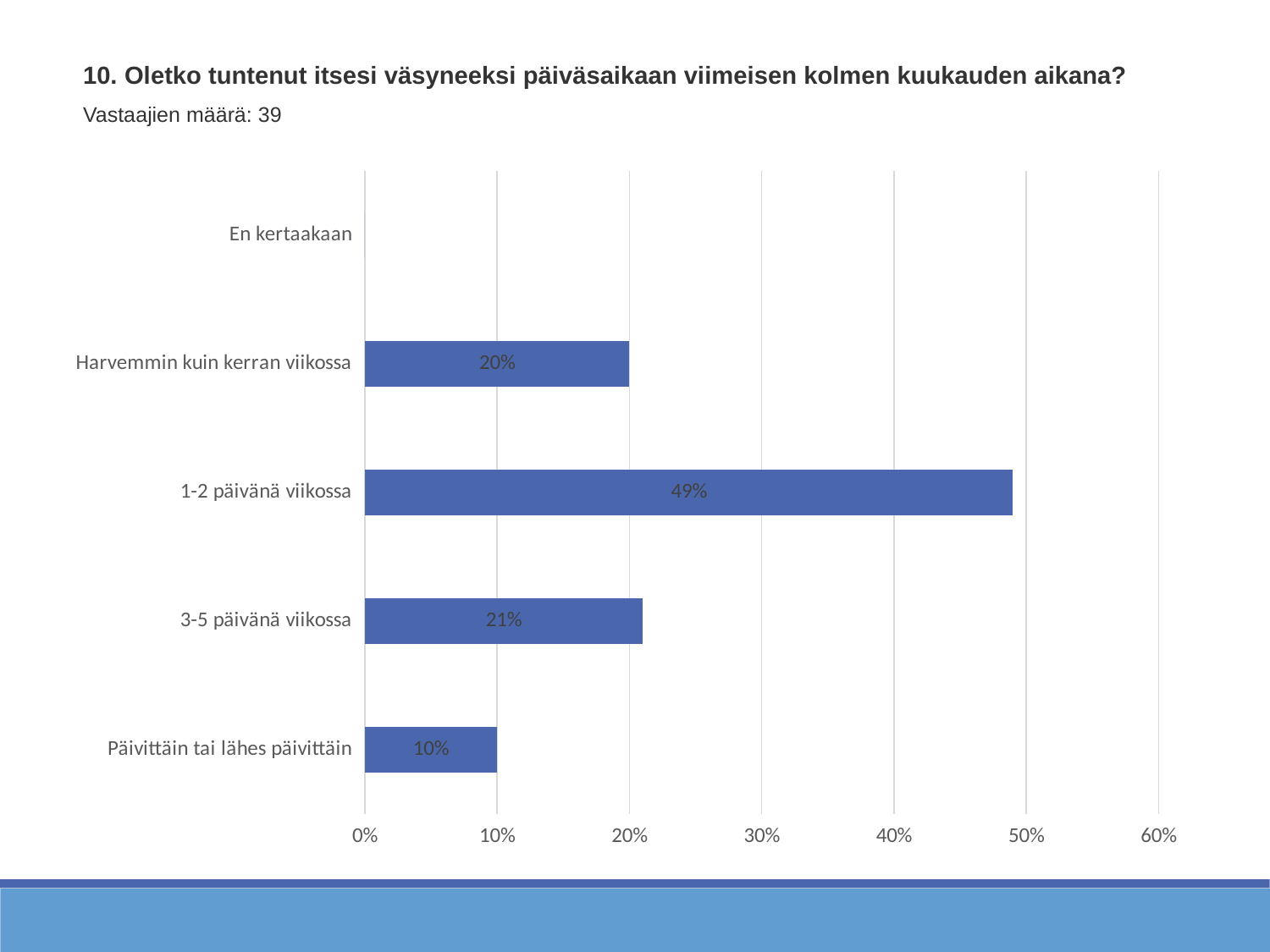
Which is larger, the value for "Harvemmin kuin kerran viikossa" or the value for "Päivittäin tai lähes päivittäin"? Harvemmin kuin kerran viikossa What kind of chart is shown on the slide? bar chart What is the value shown for "3-5 päivänä viikossa"? 21% What percentage of respondents answered "1-2 päivänä viikossa"? 49% What is the difference between the values for "1-2 päivänä viikossa" and "3-5 päivänä viikossa"? 28% How many categories are shown on the chart? 5 Which category has the lowest value? En kertaakaan Which category has the highest value? 1-2 päivänä viikossa Is the value for "1-2 päivänä viikossa" greater or less than 40%? greater What is the value shown for "Harvemmin kuin kerran viikossa"? 20% What is the value shown for "Päivittäin tai lähes päivittäin"? 10% How many respondents (Vastaajien määrä) does the slide report? 39